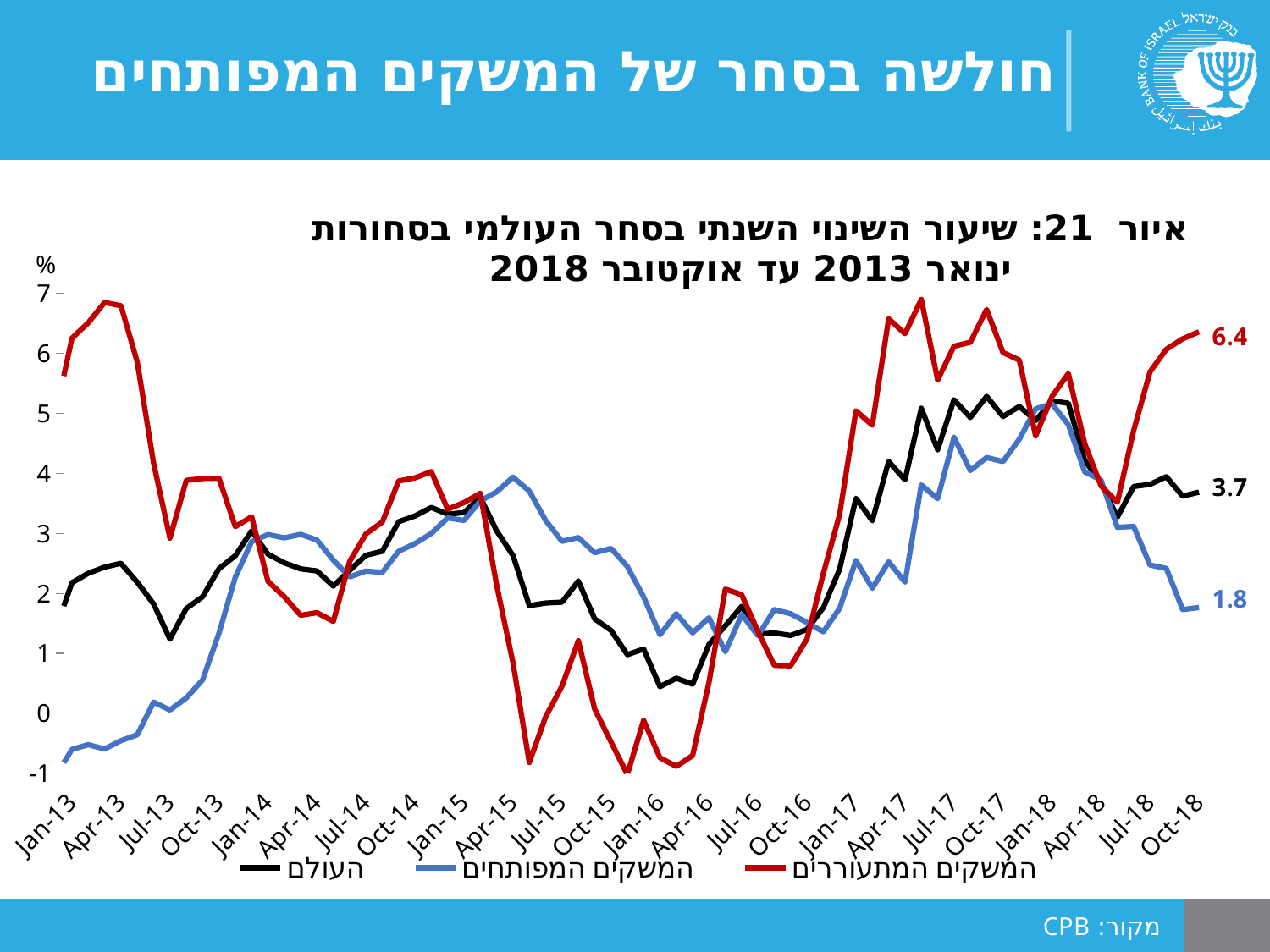
What is the value for המשקים המפותחים (developed economies) at the end of the series, Oct-18? 1.8 At Oct-18, which is larger: the value for העולם or the value for המשקים המפותחים? העולם What is the value for העולם (world) at the end of the series, Oct-18? 3.7 What is the difference between the Oct-18 values of המשקים המתעוררים and המשקים המפותחים? 4.6 Is the value for המשקים המתעוררים at Apr-13 greater or less than 6? greater What is the value for המשקים המתעוררים (emerging economies) at the end of the series, Oct-18? 6.4 How many series does the legend list? 3 Which series has the lowest value at Oct-18? המשקים המפותחים What kind of chart is shown on the slide? Line chart Which series has the highest value at Oct-18? המשקים המתעוררים What is the difference between the Oct-18 values of העולם and המשקים המפותחים? 1.9